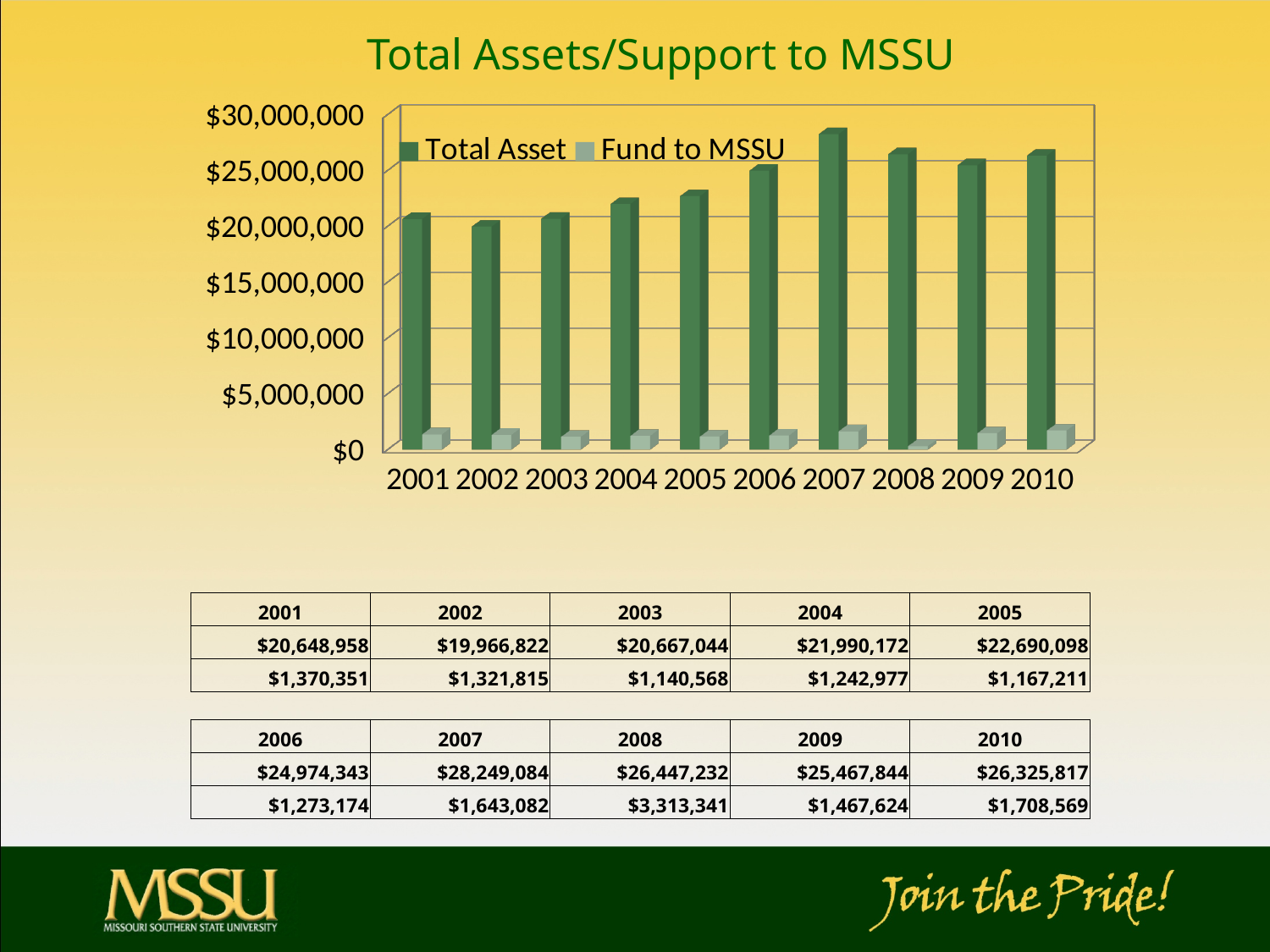
Which year has the highest Total Asset value? 2007 What type of chart is shown on the slide? bar chart What is the Total Asset value for 2001? $20,648,958 Which year has the lowest Total Asset value? 2002 What is the difference between the Total Asset values for 2007 and 2002? $8,282,262 What is the Total Asset value for 2007? $28,249,084 Is the Total Asset value for 2006 greater or less than $25,000,000? less How many series does the legend list? 2 What is the title of the chart? Total Assets/Support to MSSU Which is larger, the Total Asset value for 2004 or for 2005? 2005 What is the Fund to MSSU value for 2010? $1,708,569 How many years are shown on the x axis of the chart? 10